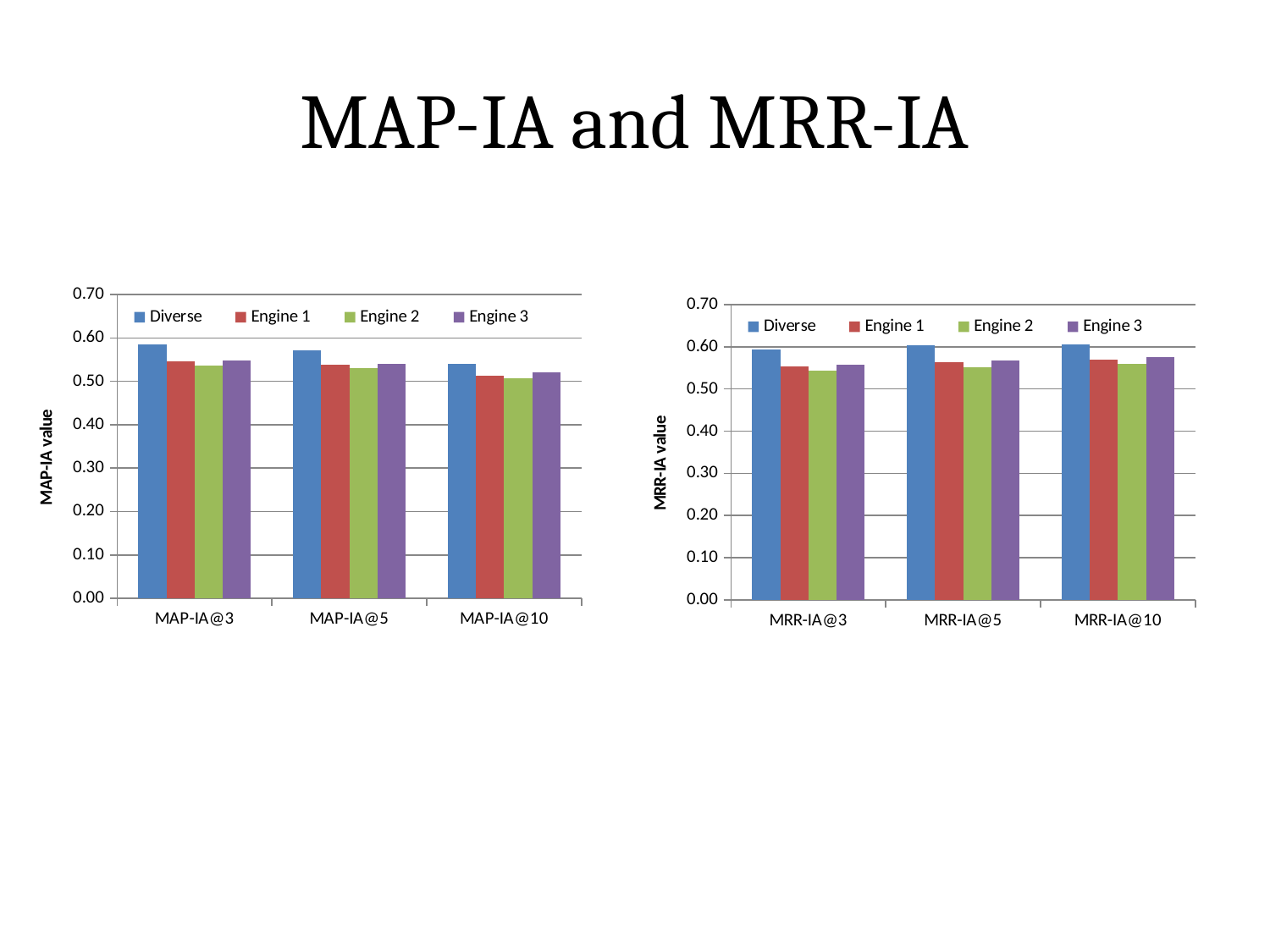
In the left chart (MAP-IA value), is the value for Engine 2 at MAP-IA@10 greater or less than 0.60? less How many categories are shown on the x axis of the left chart (MAP-IA value)? 3 What is the y-axis title of the right chart? MRR-IA value In the left chart (MAP-IA value), do the Diverse bars rise or fall from MAP-IA@3 to MAP-IA@10? fall What colour are the Engine 3 bars in the left chart (MAP-IA value)? purple In the left chart (MAP-IA value), is the value for Diverse at MAP-IA@3 greater or less than 0.50? greater In the left chart (MAP-IA value), which series has the highest bar at MAP-IA@3? Diverse In the right chart (MRR-IA value), which series has the highest bar at MRR-IA@10? Diverse In the left chart (MAP-IA value), which is larger at MAP-IA@3: Diverse or Engine 2? Diverse How many series does the legend of the right chart (MRR-IA value) list? 4 What kind of chart is the left chart (MAP-IA value)? bar chart In the right chart (MRR-IA value), is the value for Diverse at MRR-IA@5 greater or less than 0.50? greater